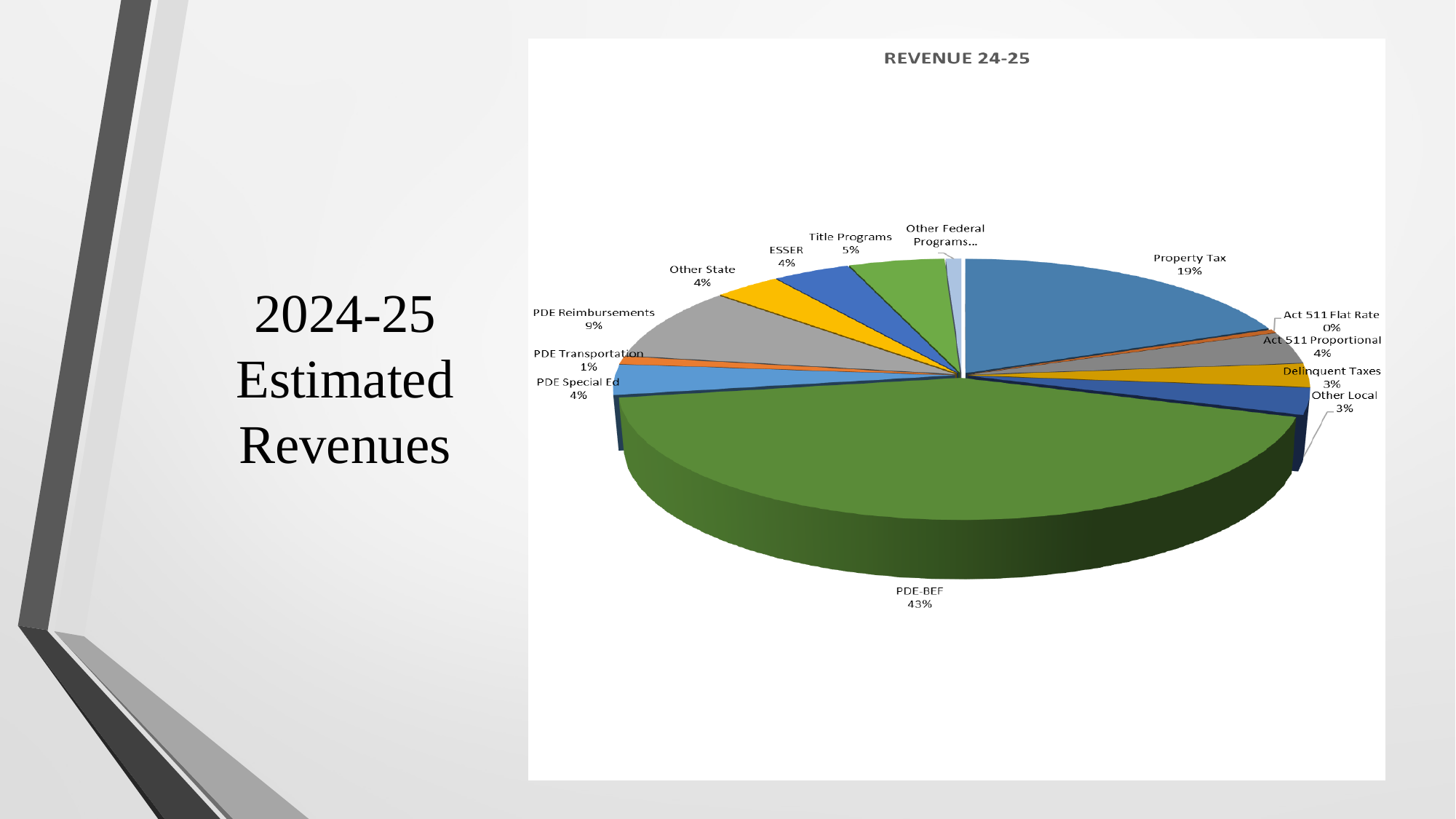
What kind of chart is shown on the slide? pie chart What percentage is shown for PDE Reimbursements? 9% What is the title of the chart? REVENUE 24-25 What share of revenue does Property Tax represent? 19% What share of revenue does PDE-BEF represent? 43% Which is larger, the share for PDE Reimbursements or the share for Title Programs? PDE Reimbursements How many categories are shown in the pie chart? 13 Which category has the largest slice of the pie? PDE-BEF What is the difference in percentage points between PDE-BEF and Property Tax? 24 Which category has the smallest share, shown as 0%? Act 511 Flat Rate What percentage is shown for PDE Transportation? 1% What percentage is shown for Title Programs? 5%